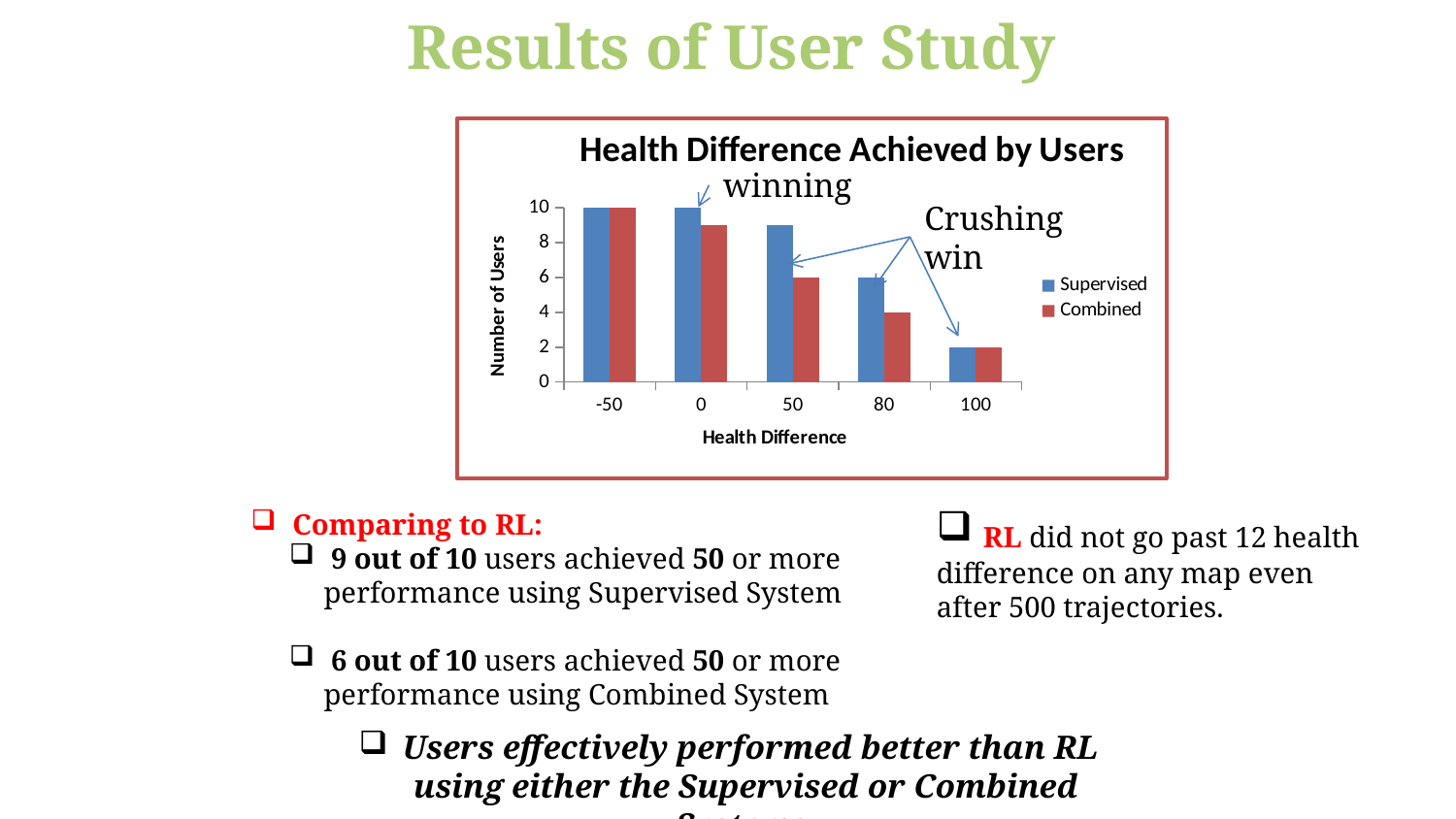
How many Health Difference categories are shown on the x axis of the chart? 5 Do the values for the Supervised series rise or fall as Health Difference increases along the x axis? fall What is the number of users for the Combined series at a Health Difference of 80? 4 At a Health Difference of 80, which series has more users, Supervised or Combined? Supervised What kind of chart is shown on the slide? bar chart What is the number of users for the Supervised series at a Health Difference of -50? 10 What is the title of the chart? Health Difference Achieved by Users What is the number of users for the Combined series at a Health Difference of 50? 6 Is the value for the Supervised series at a Health Difference of 50 greater or less than 8? greater How many series does the legend of the chart list? 2 At a Health Difference of 80, what is the difference in number of users between the Supervised and Combined series? 2 What is the number of users for the Supervised series at a Health Difference of 100? 2